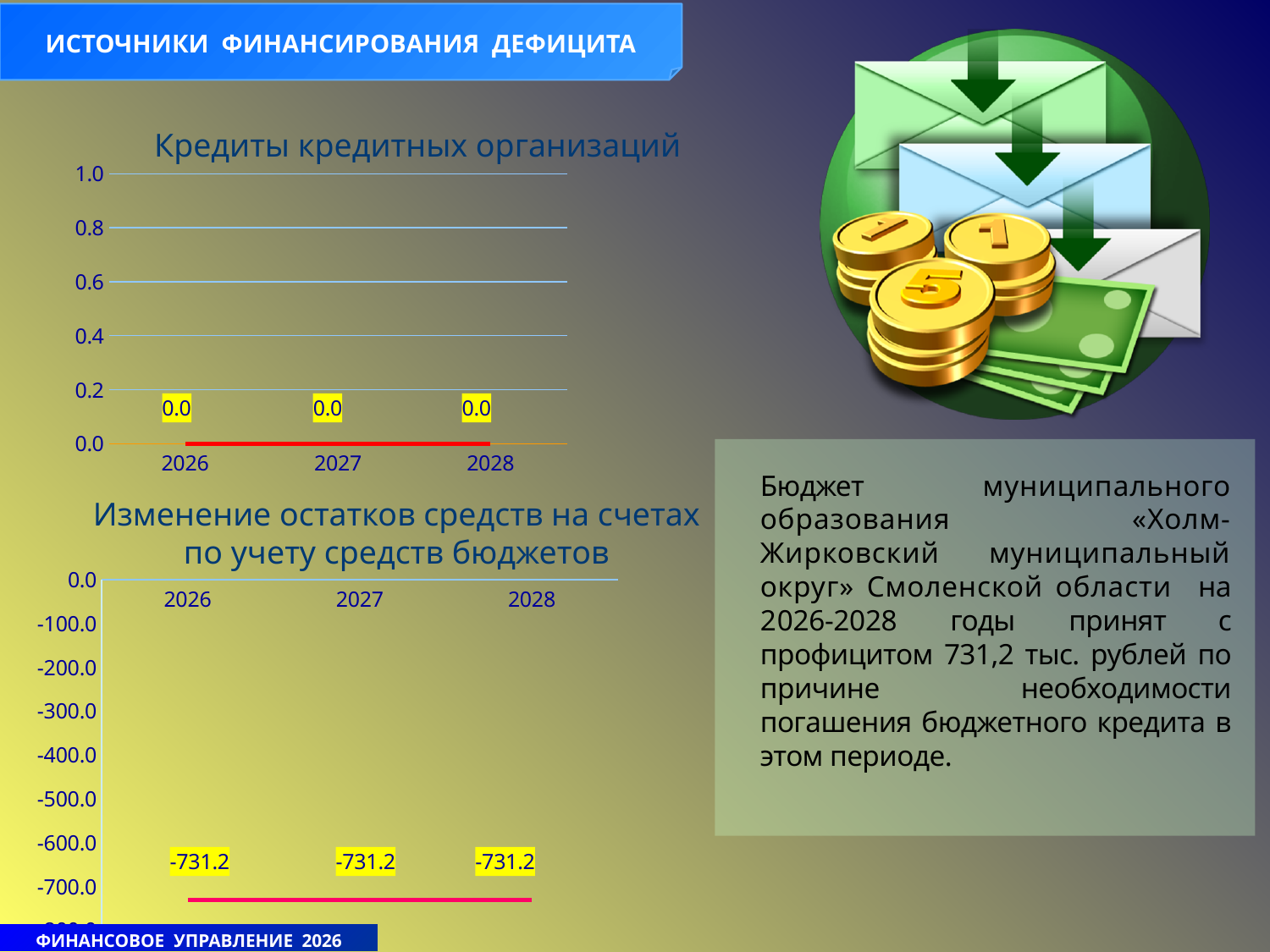
In the chart 'Изменение остатков средств на счетах по учету средств бюджетов', do the values rise, fall or stay flat across the years? stay flat In the chart 'Изменение остатков средств на счетах по учету средств бюджетов', how many data points are plotted? 3 What colour is the plotted line in the chart 'Кредиты кредитных организаций'? red What type of chart is 'Кредиты кредитных организаций'? line chart In the chart 'Кредиты кредитных организаций', how many years are shown on the x axis? 3 In the chart 'Изменение остатков средств на счетах по учету средств бюджетов', what is the value for 2028? -731.2 In the chart 'Кредиты кредитных организаций', what is the difference between the values for 2026 and 2028? 0.0 In the chart 'Изменение остатков средств на счетах по учету средств бюджетов', is the value for 2027 greater or less than -500.0? less In the chart 'Изменение остатков средств на счетах по учету средств бюджетов', what is the value for 2026? -731.2 In the chart 'Кредиты кредитных организаций', do the values rise, fall or stay flat from 2026 to 2028? stay flat In the chart 'Кредиты кредитных организаций', what is the value for 2027? 0.0 What is the title of the bottom chart on the slide? Изменение остатков средств на счетах по учету средств бюджетов